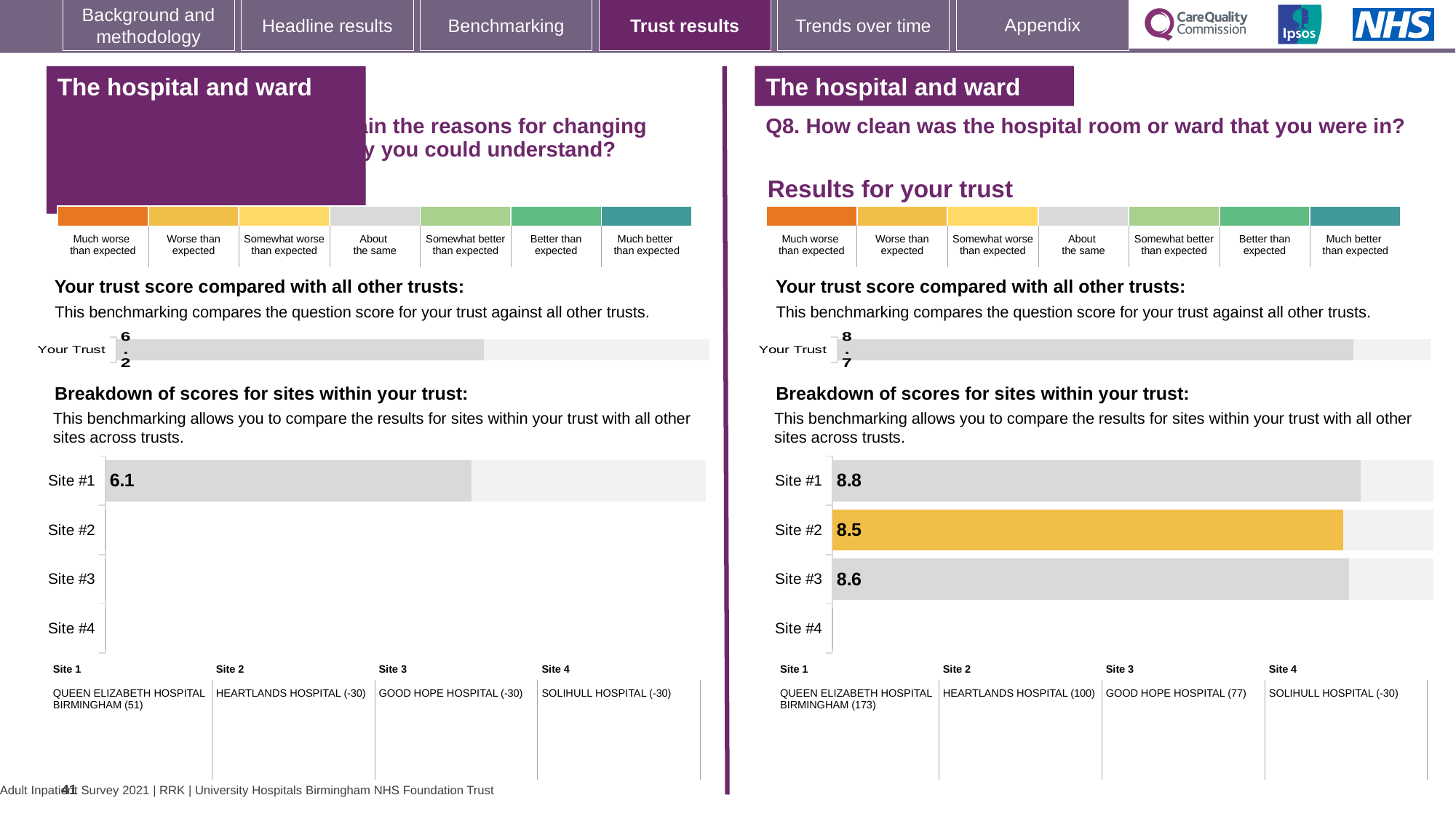
In the left-hand 'Breakdown of scores for sites within your trust' chart, what is the score for Site #1? 6.1 What type of chart is used for the Q8 site breakdown on the right? Bar chart In the Q8 site breakdown chart on the right, which of the sites with a plotted score has the lowest score? Site #2 In the Q8 'Breakdown of scores for sites within your trust' chart on the right, what is the score for Site #2? 8.5 In the Q8 site breakdown chart on the right, which site has the highest score? Site #1 In the Q8 site breakdown chart on the right, how many sites have a plotted bar with a score? 3 In the Q8 site breakdown chart on the right, which has the higher score, Site #2 or Site #3? Site #3 In the Q8 'Your trust score compared with all other trusts' chart on the right, what is the score for Your Trust? 8.7 In the Q8 'Breakdown of scores for sites within your trust' chart on the right, what is the score for Site #1? 8.8 In the Q8 'Breakdown of scores for sites within your trust' chart on the right, what is the score for Site #3? 8.6 In the left-hand 'Your trust score compared with all other trusts' chart, what is the score for Your Trust? 6.2 In the Q8 site breakdown chart on the right, what is the difference between the scores for Site #1 and Site #2? 0.3